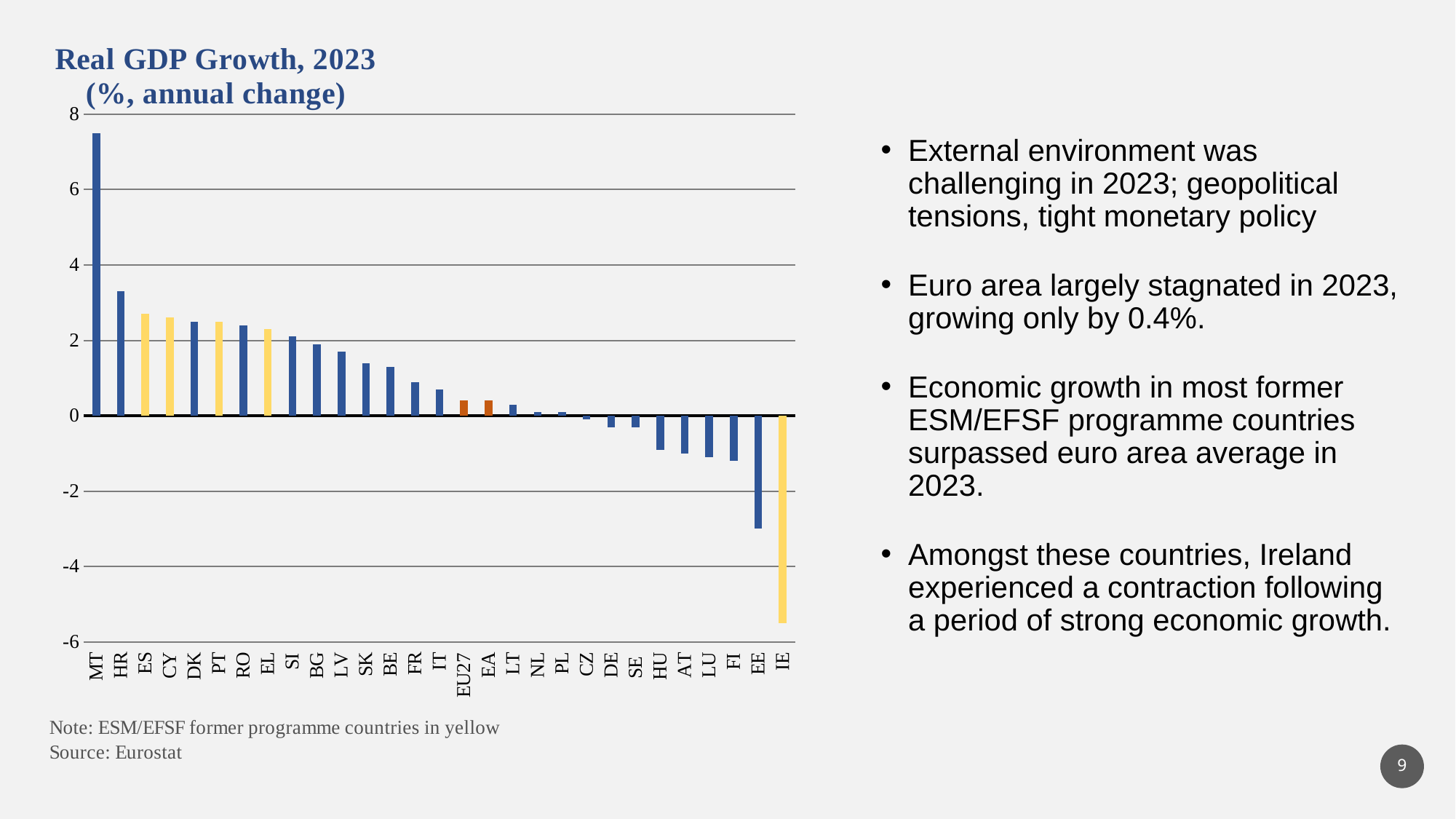
Which has the lower real GDP growth, EE or IE? IE According to the note, what do the yellow bars represent? ESM/EFSF former programme countries Do the values rise or fall moving from left to right along the x axis? Fall Is the value for HR greater or less than 2? greater What kind of chart is shown on the slide? Bar chart Is the value for EE greater or less than -2? less How many countries or aggregates are shown on the x axis of the chart? 29 Which country has the lowest real GDP growth in 2023 in the chart? IE Which has the higher real GDP growth, MT or HR? MT Is the value for IE greater or less than -4? less Which country has the highest real GDP growth in 2023 in the chart? MT